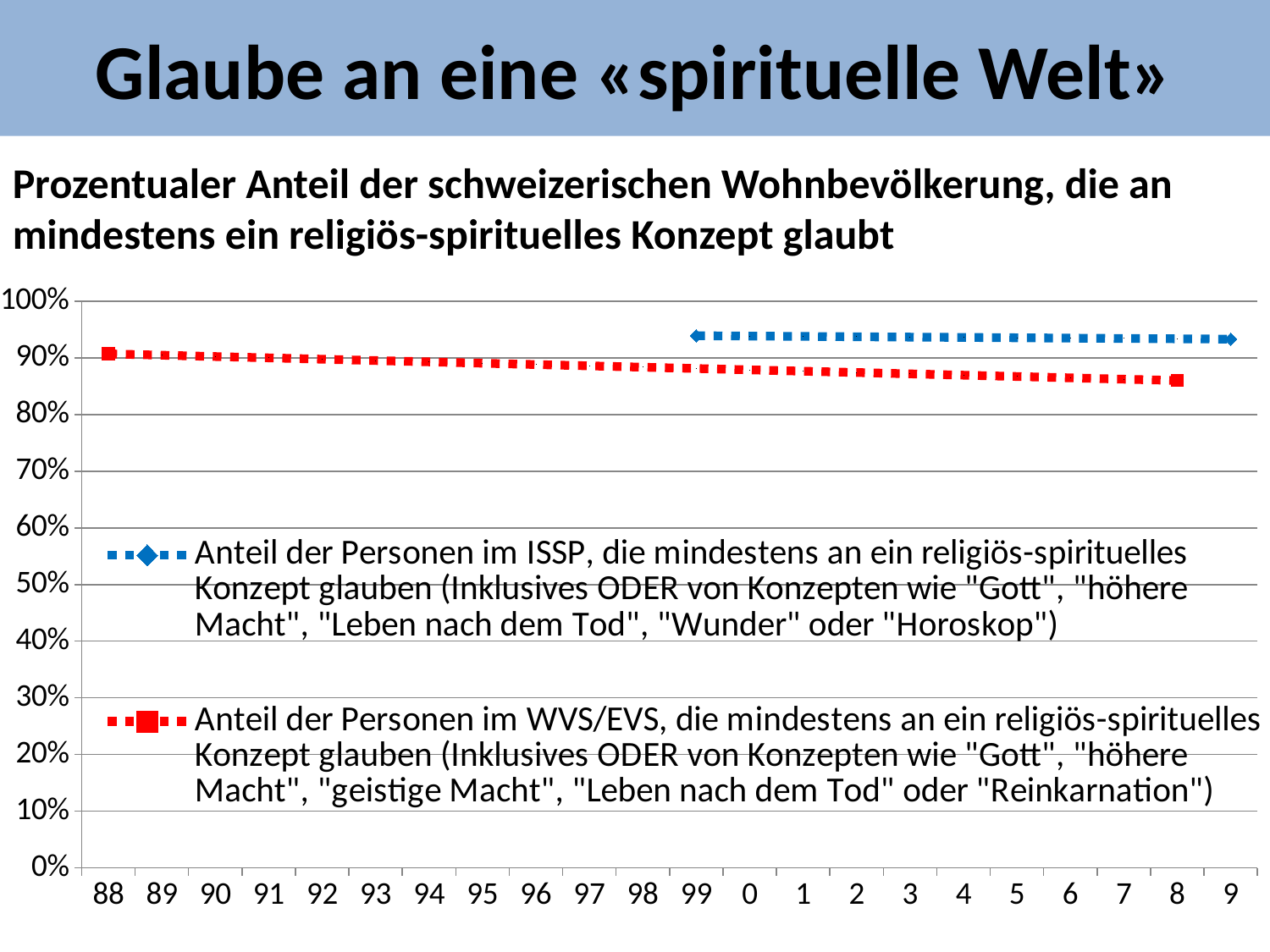
Is the value of the ISSP series (blue) at 99 greater or less than 90%? greater What colour is the line for the ISSP series? blue At 8 on the x axis, which series has the higher value, ISSP or WVS/EVS? ISSP What kind of chart is shown on the slide? line chart How many year labels are shown along the x axis? 22 Is the value of the WVS/EVS series (red) at 88 greater or less than 80%? greater Is the value of the ISSP series (blue) at 9 greater or less than 100%? less What is the title of the slide? Glaube an eine «spirituelle Welt» How many series does the legend list? 2 Do the values of the WVS/EVS series (red) rise or fall from 88 to 8 along the x axis? fall At 99 on the x axis, which series has the lower value, ISSP or WVS/EVS? WVS/EVS